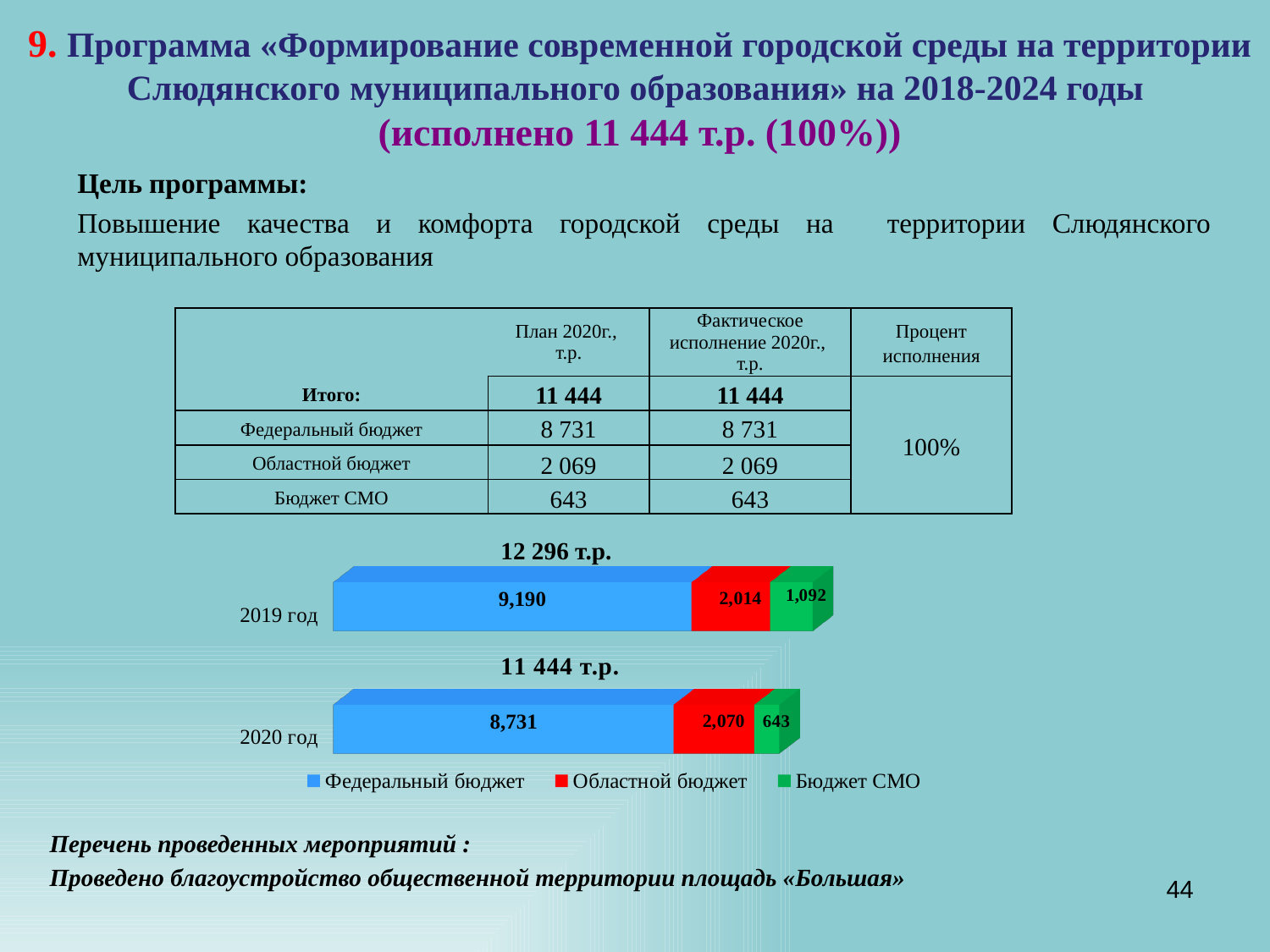
What is the value for Федеральный бюджет in 2019 год? 9,190 What is the value for Бюджет СМО in 2019 год? 1,092 Which series has the largest value in 2020 год? Федеральный бюджет How many series does the legend list? 3 What is the value for Областной бюджет in 2020 год? 2,070 What is the value for Бюджет СМО in 2020 год? 643 Which series has the smallest value in 2019 год? Бюджет СМО What is the difference between the Федеральный бюджет values for 2019 год and 2020 год? 459 Which is larger: Бюджет СМО in 2019 год or Бюджет СМО in 2020 год? 2019 год What is the total of the stacked bar for 2019 год? 12 296 т.р. What kind of chart is shown on the slide? Stacked bar chart What is the total of the stacked bar for 2020 год? 11 444 т.р.